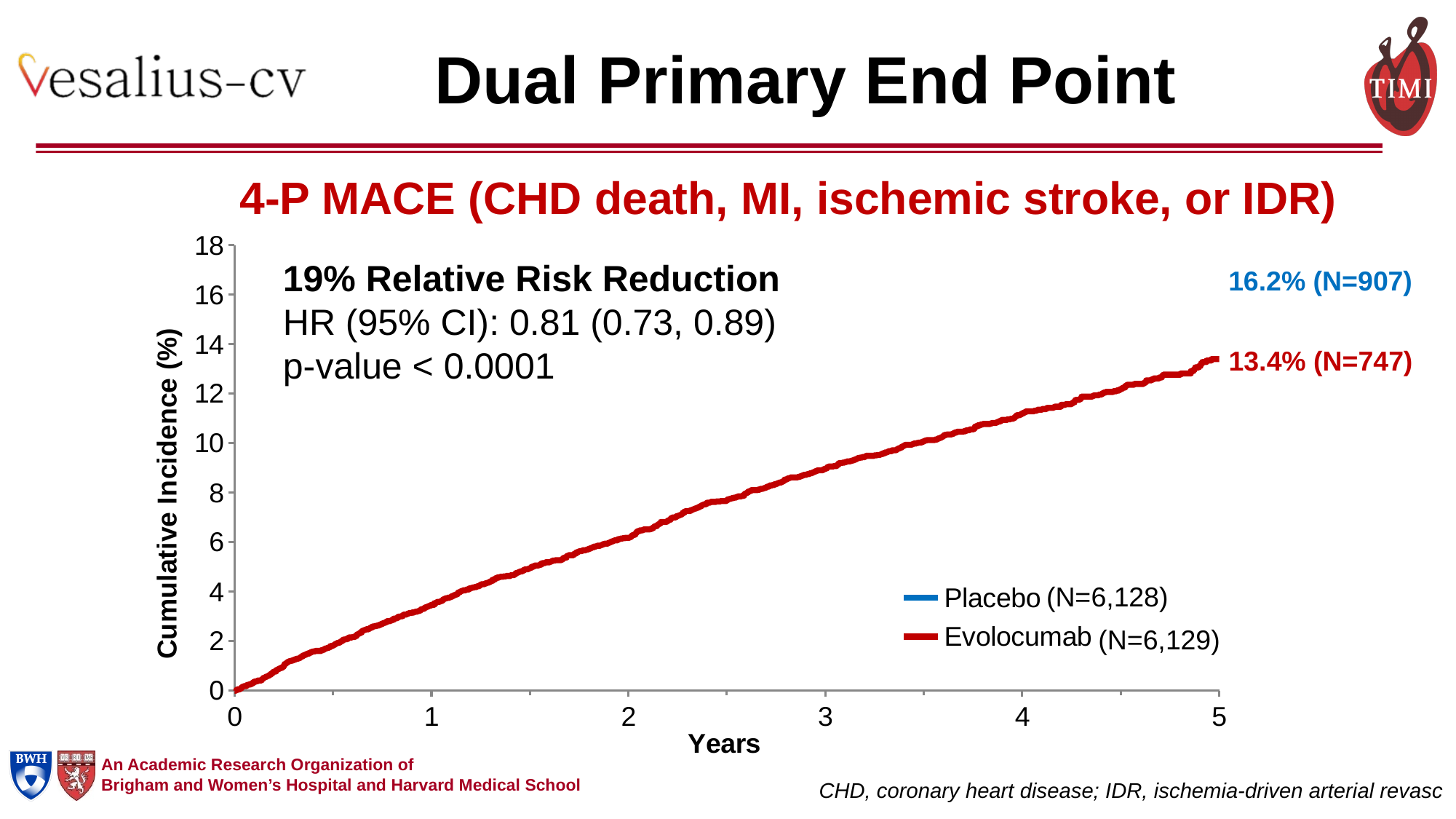
Is the cumulative incidence for Evolocumab at year 3 greater or less than 8? greater Is the cumulative incidence for Evolocumab at year 1 greater or less than 6? less What is the cumulative incidence labeled for the Placebo group at the end of follow-up? 16.2% What type of chart is shown on the slide? line chart How many series does the legend list? 2 Which group has the higher labeled cumulative incidence, Placebo or Evolocumab? Placebo How many events (N) are labeled for the Evolocumab group? 747 What is the cumulative incidence labeled for the Evolocumab group at the end of follow-up? 13.4% What is the label of the y-axis? Cumulative Incidence (%) What is the difference in percentage points between the labeled Placebo and Evolocumab cumulative incidences? 2.8 How many events (N) are labeled for the Placebo group? 907 Does the Evolocumab curve rise or fall as years increase? rise